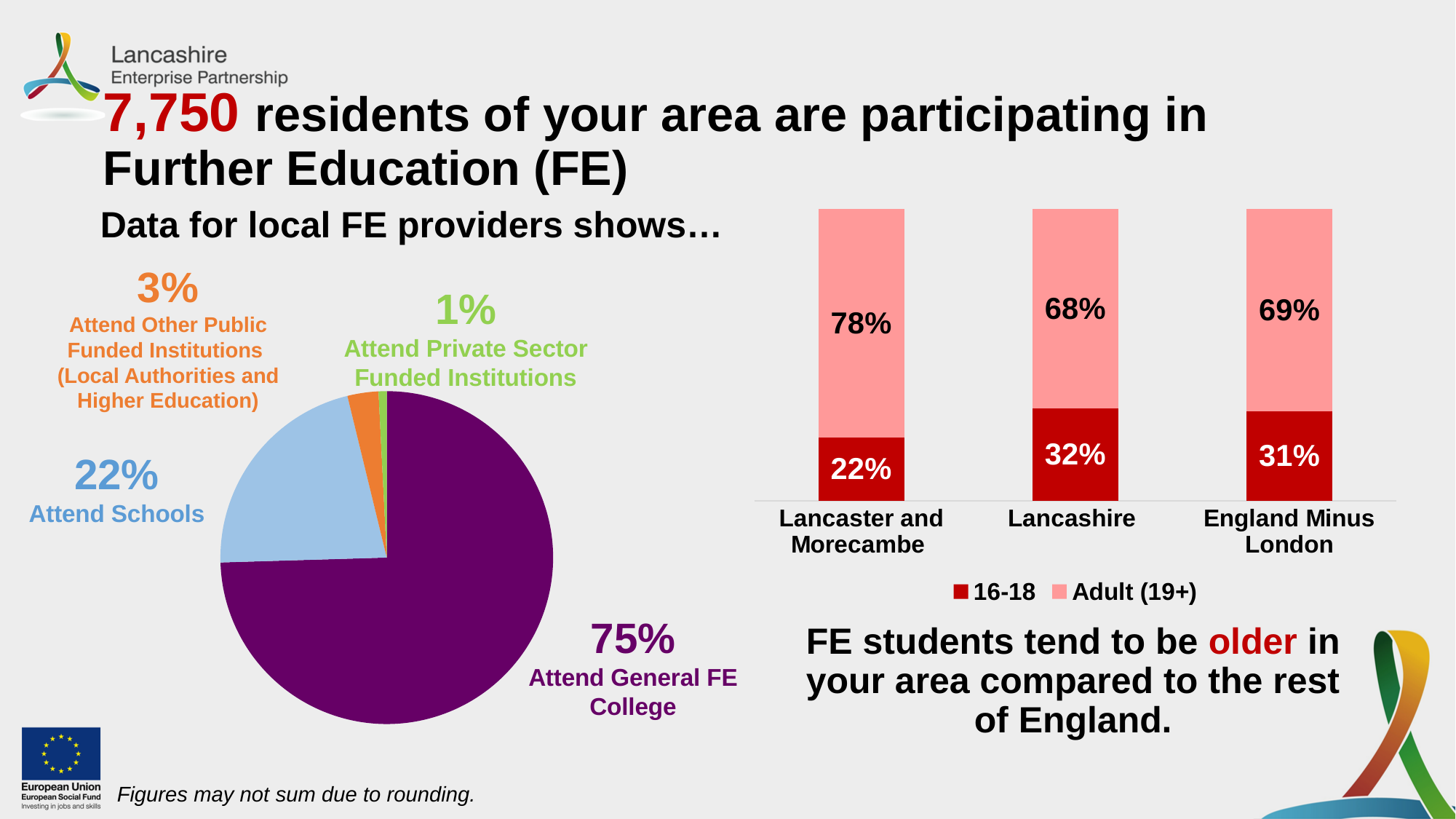
What kind of chart is the chart on the left of the slide? Pie chart On the stacked bar chart on the right, is the 16-18 share larger for Lancashire or for England Minus London? Lancashire On the stacked bar chart on the right, what is the Adult (19+) value for Lancashire? 68% On the stacked bar chart on the right, how many series does the legend list? 2 On the pie chart on the left, how many slices are shown? 4 What kind of chart is the chart on the right of the slide? Stacked bar chart On the stacked bar chart on the right, which area has the highest Adult (19+) share? Lancaster and Morecambe On the pie chart on the left, what share of FE participants attend General FE College? 75% On the stacked bar chart on the right, what is the 16-18 value for Lancaster and Morecambe? 22% On the stacked bar chart on the right, what is the difference between the 16-18 share for Lancashire and for Lancaster and Morecambe? 10% On the pie chart on the left, which category has the smallest share? Attend Private Sector Funded Institutions On the pie chart on the left, what share of FE participants attend Schools? 22%